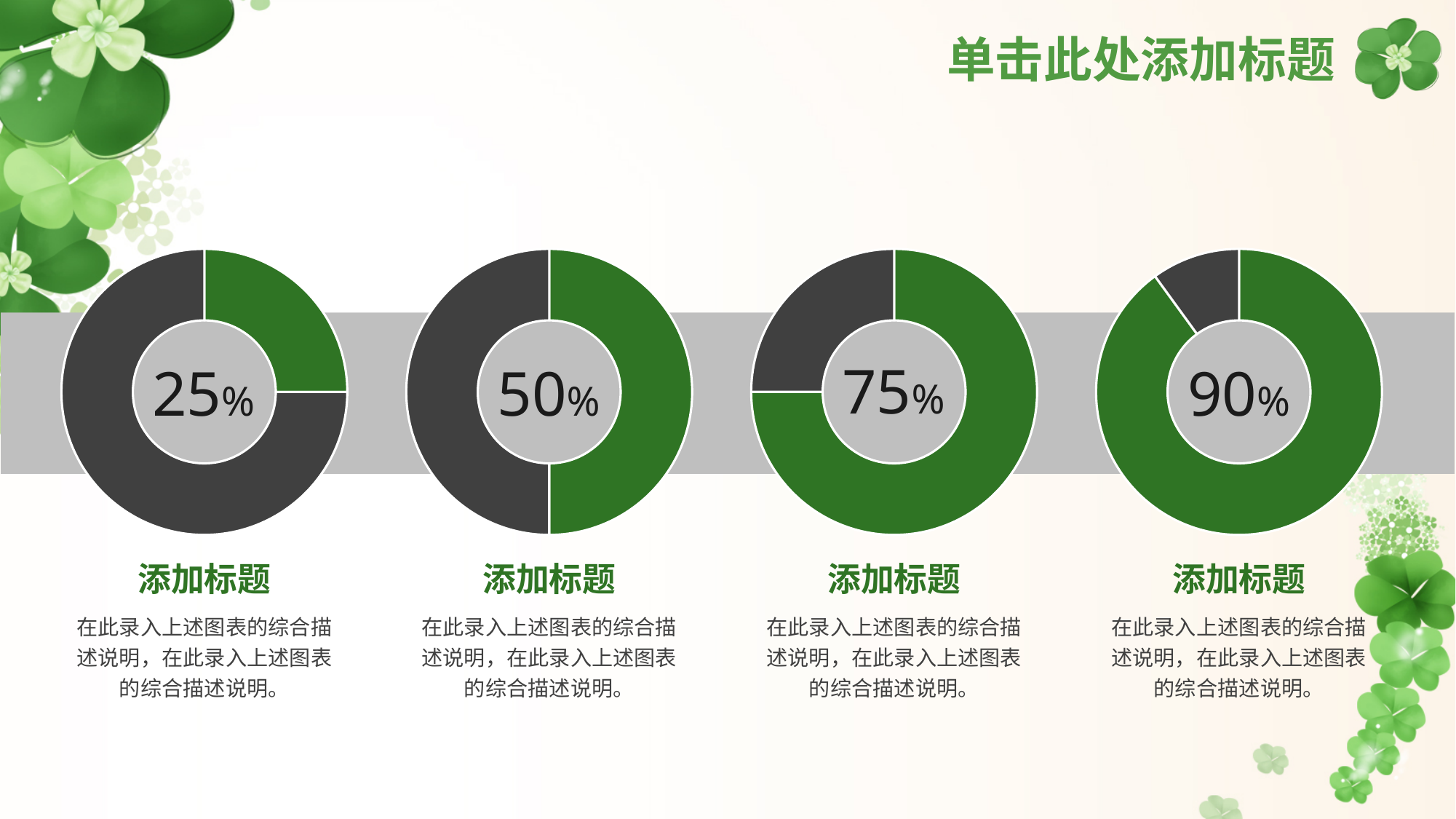
Do the percentages in the donut charts rise or fall from left to right across the slide? Rise What is the difference between the percentage in the rightmost donut chart and the percentage in the leftmost donut chart? 65% What kind of chart is used for each of the four figures on the slide? Donut chart In the leftmost donut chart, what colour is the segment representing the 25% share? Green Which is larger: the percentage in the second donut chart from the left or the percentage in the third donut chart from the left? The third donut chart (75%) Which donut chart on the slide shows the highest percentage? The rightmost one (90%) What percentage is shown in the centre of the second donut chart from the left? 50% How many donut charts are on the slide? 4 What percentage is shown in the centre of the rightmost donut chart? 90% What percentage is shown in the centre of the leftmost donut chart? 25% Which donut chart on the slide shows the lowest percentage? The leftmost one (25%) What percentage is shown in the centre of the third donut chart from the left? 75%